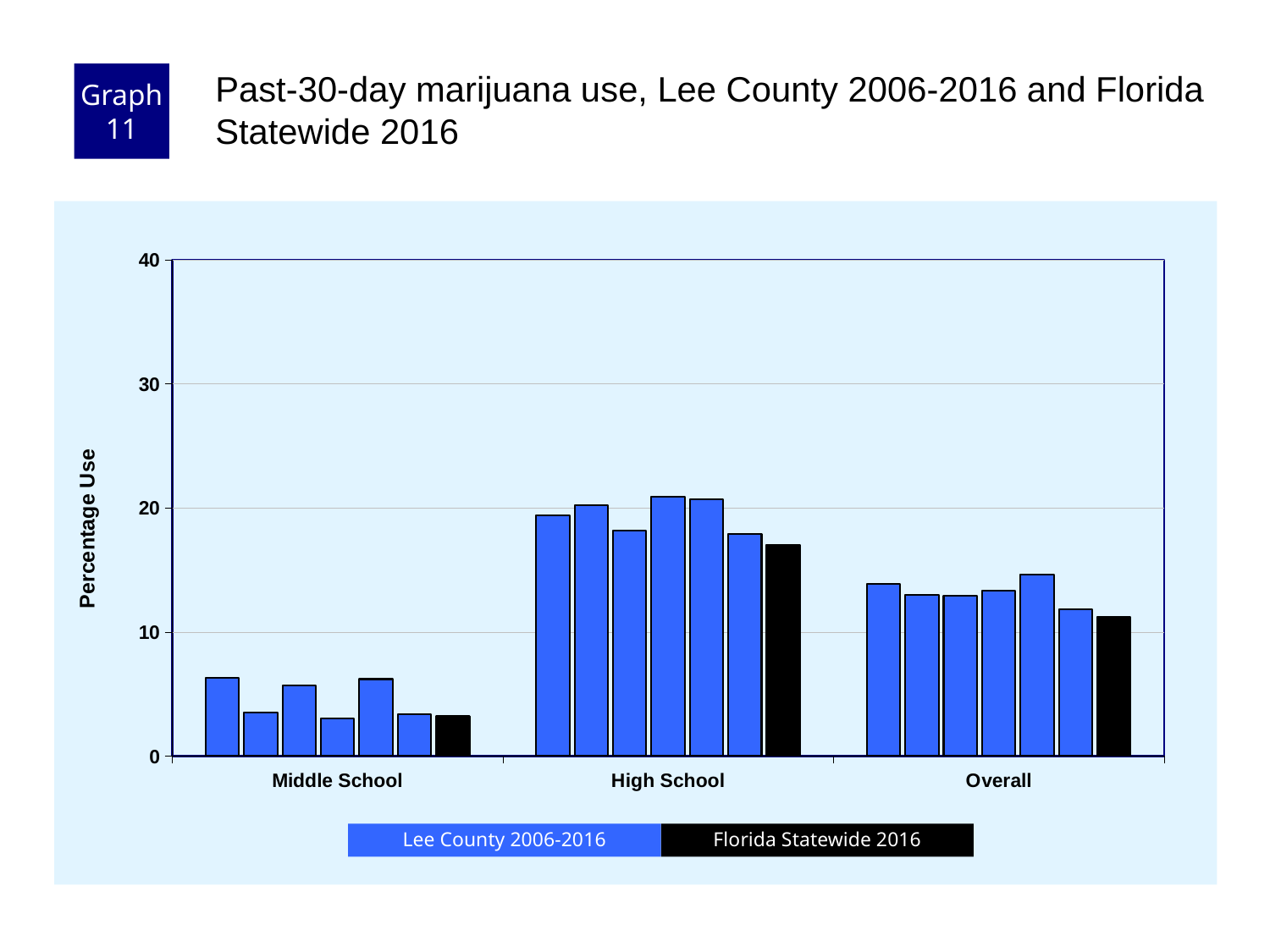
Which is larger, the Florida Statewide 2016 value for High School or for Middle School? High School Which category has the lowest percentage use values overall? Middle School What is the label of the y axis? Percentage Use Is the Florida Statewide 2016 value for Middle School greater or less than 10? less Which category has the highest percentage use values overall? High School What kind of chart is shown on the slide? bar chart How many school-level categories are shown on the x axis? 3 Is the Florida Statewide 2016 value for Overall greater or less than 20? less Is the Florida Statewide 2016 value for High School greater or less than 20? less Which colour represents Florida Statewide 2016 in the legend? black How many series does the legend list? 2